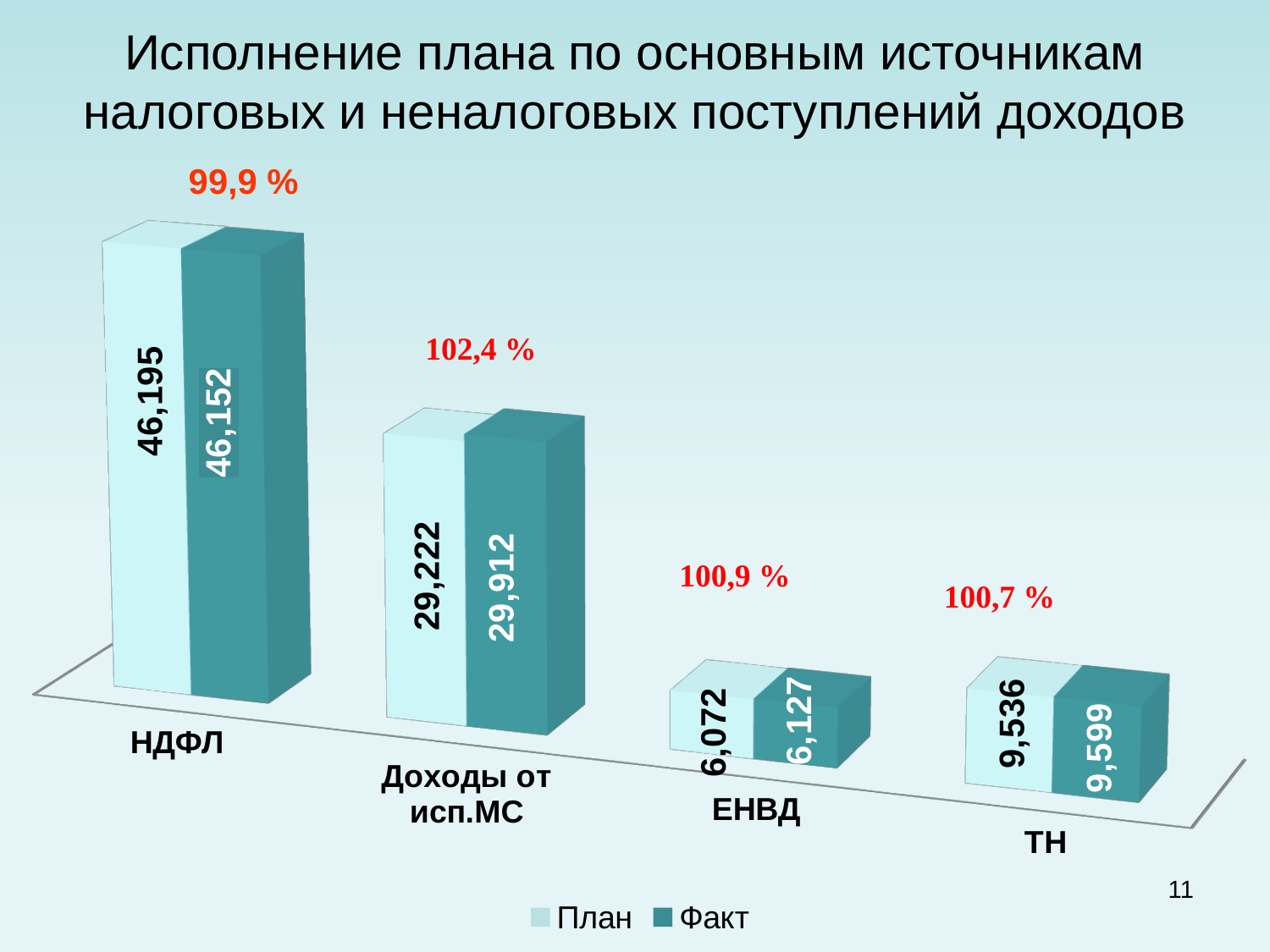
Which is larger for ТН, the План value or the Факт value? Факт How many series does the legend list? 2 What is the Факт value for ТН? 9,599 What is the План value for ЕНВД? 6,072 Which category has the highest Факт value? НДФЛ What is the План value for НДФЛ? 46,195 Which category has the lowest План value? ЕНВД What percentage is shown above the bars for Доходы от исп.МС? 102,4 % What is the difference between the Факт and План values for Доходы от исп.МС? 0,690 What is the Факт value for Доходы от исп.МС? 29,912 How many categories are shown on the x axis? 4 What kind of chart is shown on the slide? Bar chart